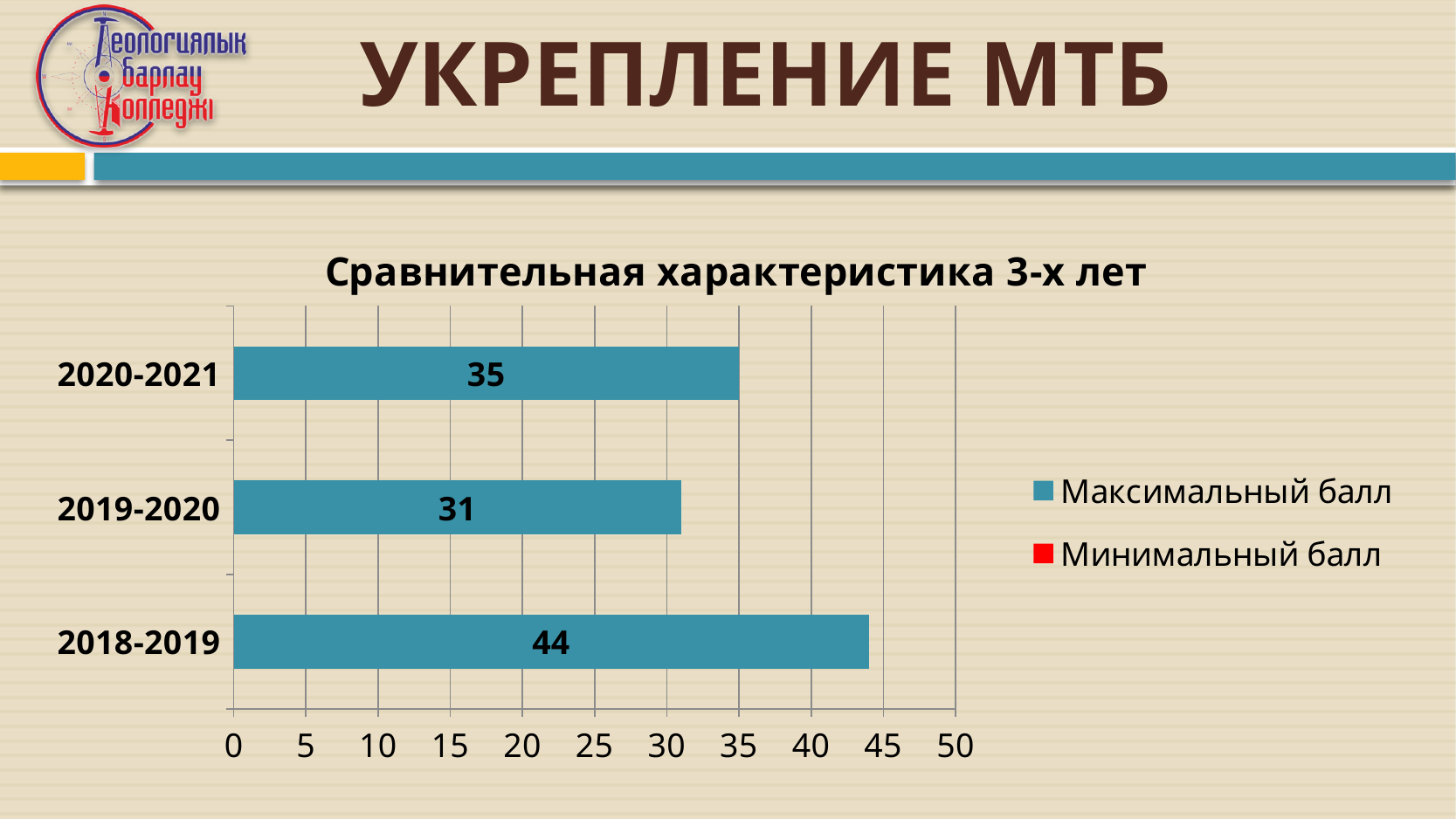
What is the value for 2019-2020? 31 What is the difference between the values for 2018-2019 and 2020-2021? 9 How many categories are shown on the chart? 3 What is the title of the chart? Сравнительная характеристика 3-х лет Which category has the highest value? 2018-2019 Which is larger, the value for 2019-2020 or the value for 2018-2019? 2018-2019 Which category has the lowest value? 2019-2020 What is the value for 2018-2019? 44 What kind of chart is shown on the slide? Bar chart What is the difference between the values for 2020-2021 and 2019-2020? 4 What is the value for 2020-2021? 35 How many series does the legend list? 2